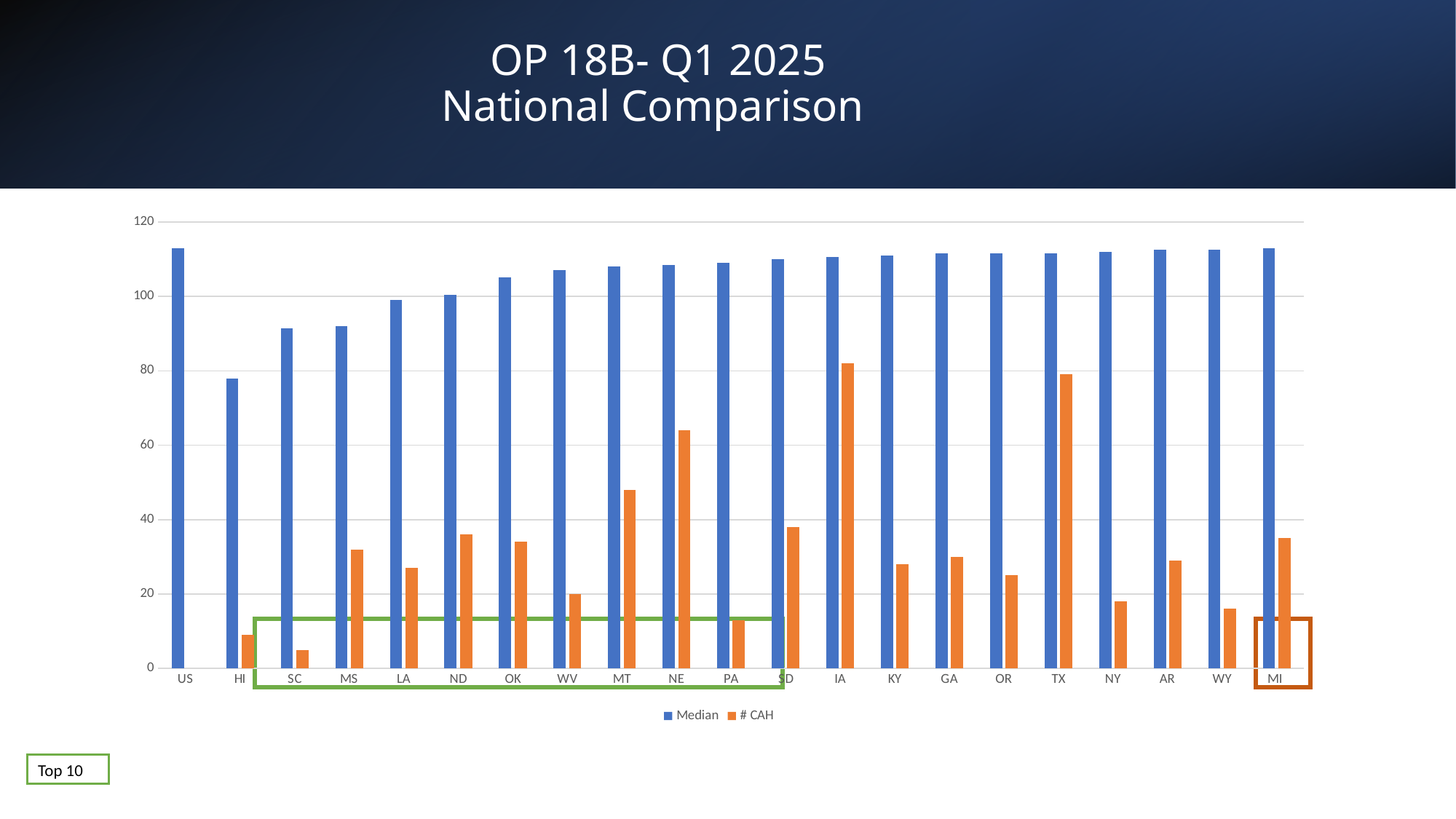
What are the two series named in the legend? Median and # CAH What kind of chart is shown on the slide? Bar chart What is the title of the chart slide? OP 18B- Q1 2025 National Comparison Is the Median value for HI greater or less than 80? less Is the # CAH value for SC greater or less than 20? less Which is larger, the # CAH value for NE or for MT? NE How many series does the legend list? 2 Which category has the lowest Median value? HI Is the # CAH value for NE greater or less than 60? greater How many categories are shown along the x axis? 21 Do the Median values generally rise or fall moving from HI to MI along the x axis? rise